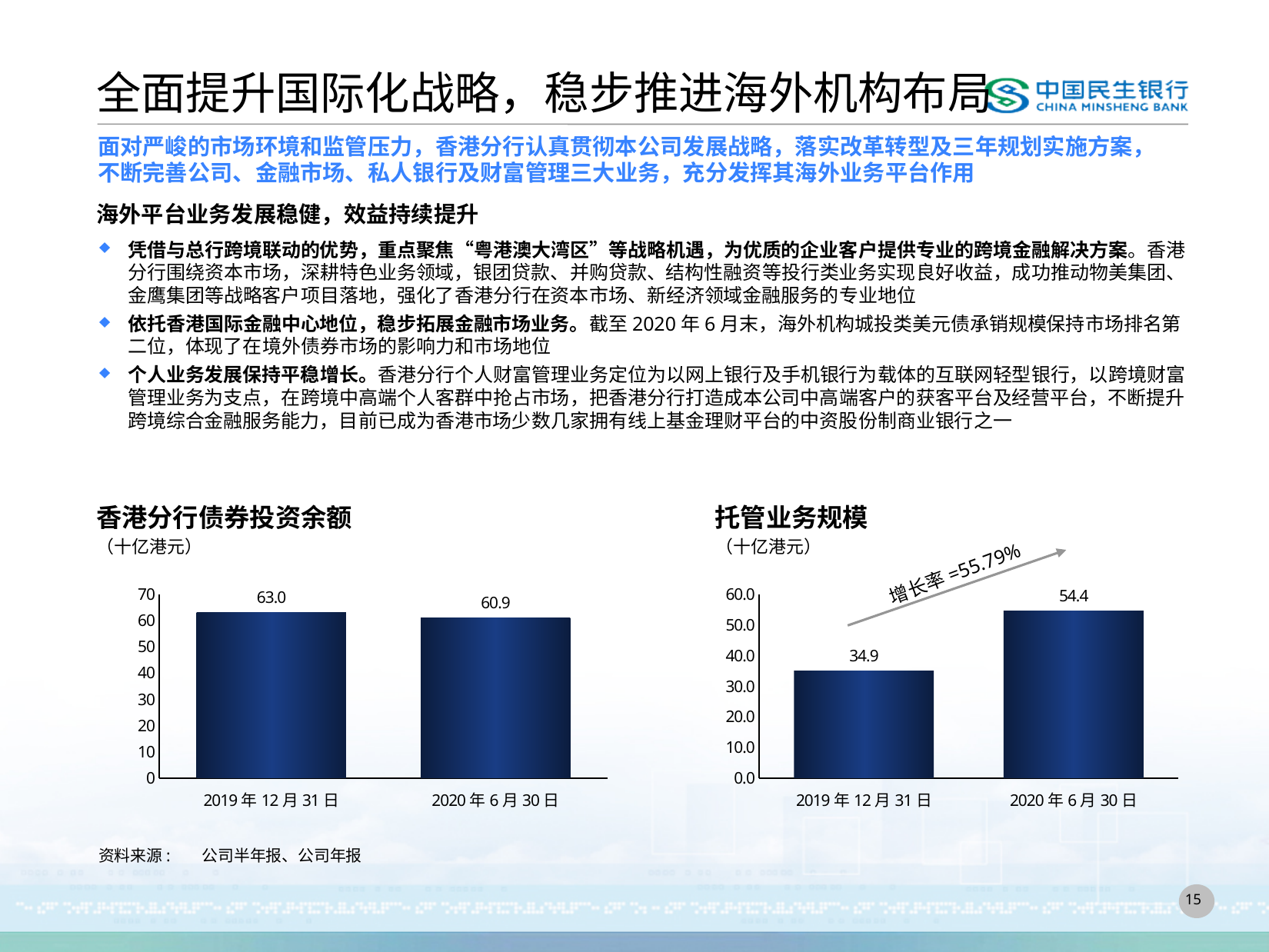
How many bars are in the 香港分行债券投资余额 chart? 2 In the 托管业务规模 chart, what is the value for 2020 年 6 月 30 日? 54.4 In the 香港分行债券投资余额 chart, which date has the lowest value? 2020 年 6 月 30 日 In the 香港分行债券投资余额 chart, what is the value for 2019 年 12 月 31 日? 63.0 In the 托管业务规模 chart, which date has the highest value? 2020 年 6 月 30 日 In the 托管业务规模 chart, do the values rise or fall from 2019 年 12 月 31 日 to 2020 年 6 月 30 日? rise What growth rate is annotated on the 托管业务规模 chart? 增长率 =55.79% In the 香港分行债券投资余额 chart, what is the value for 2020 年 6 月 30 日? 60.9 In the 托管业务规模 chart, what is the value for 2019 年 12 月 31 日? 34.9 In the 托管业务规模 chart, what is the difference between the 2020 年 6 月 30 日 value and the 2019 年 12 月 31 日 value? 19.5 What kind of chart is the 托管业务规模 chart? bar chart In the 香港分行债券投资余额 chart, what is the difference between the 2019 年 12 月 31 日 value and the 2020 年 6 月 30 日 value? 2.1